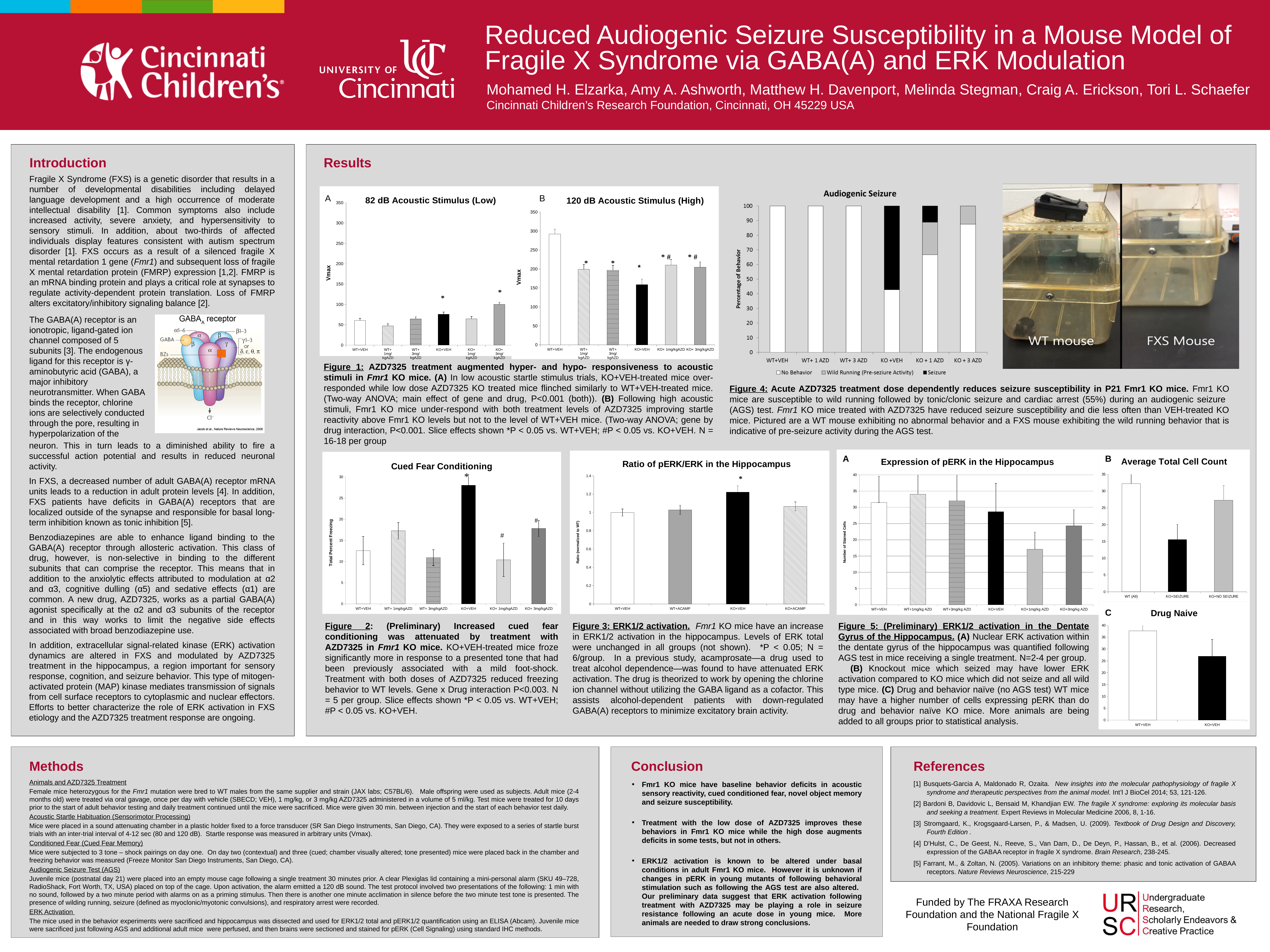
In the 'Average Total Cell Count' chart, which category has the lowest value? KO+SEIZURE In the 'Expression of pERK in the Hippocampus' chart, which category has the lowest number of stained cells? KO+1mg/kg AZD How many categories are shown in the 'Ratio of pERK/ERK in the Hippocampus' chart? 4 In the '120 dB Acoustic Stimulus (High)' chart, which category has the highest Vmax? WT+VEH How many series does the legend of the 'Audiogenic Seizure' chart list? 3 In the 'Ratio of pERK/ERK in the Hippocampus' chart, which is larger, KO+VEH or WT+VEH? KO+VEH In the '82 dB Acoustic Stimulus (Low)' chart, which category has the highest Vmax? KO+3mg/kgAZD In the 'Cued Fear Conditioning' chart, which category has the highest Total Percent Freezing? KO+VEH In the '82 dB Acoustic Stimulus (Low)' chart, is the value for WT+VEH greater or less than 100? less How many categories are shown on the x axis of the 'Audiogenic Seizure' chart? 6 In the '120 dB Acoustic Stimulus (High)' chart, is the value for KO+VEH greater or less than 200? less